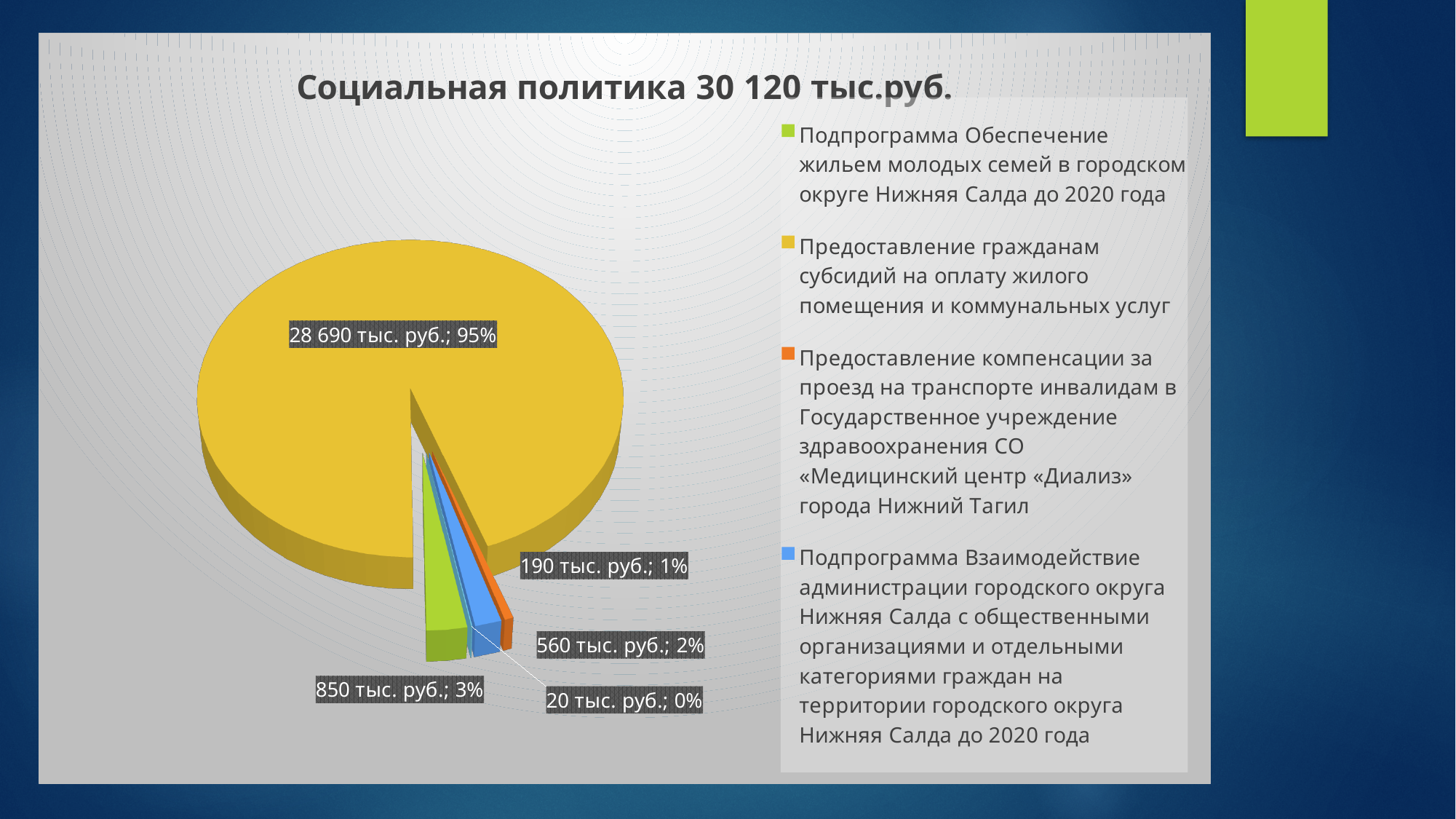
What is the value and share of the smallest labelled slice? 20 тыс. руб.; 0% What type of chart is shown on the slide? pie chart Which is larger: the slice labelled 850 тыс. руб. or the slice labelled 190 тыс. руб.? 850 тыс. руб. Which category has the largest slice of the pie? Предоставление гражданам субсидий на оплату жилого помещения и коммунальных услуг What colour is the largest slice of the pie? yellow What value is shown for Предоставление гражданам субсидий на оплату жилого помещения и коммунальных услуг? 28 690 тыс. руб. How many entries does the legend list? 4 How many data labels are shown on the pie? 5 What is the title of the chart? Социальная политика 30 120 тыс.руб. What share of the pie does Предоставление гражданам субсидий на оплату жилого помещения и коммунальных услуг take? 95% What value is shown for Подпрограмма Обеспечение жильем молодых семей в городском округе Нижняя Салда до 2020 года? 850 тыс. руб. What is the difference between the slice labelled 850 тыс. руб. and the slice labelled 560 тыс. руб.? 290 тыс. руб.